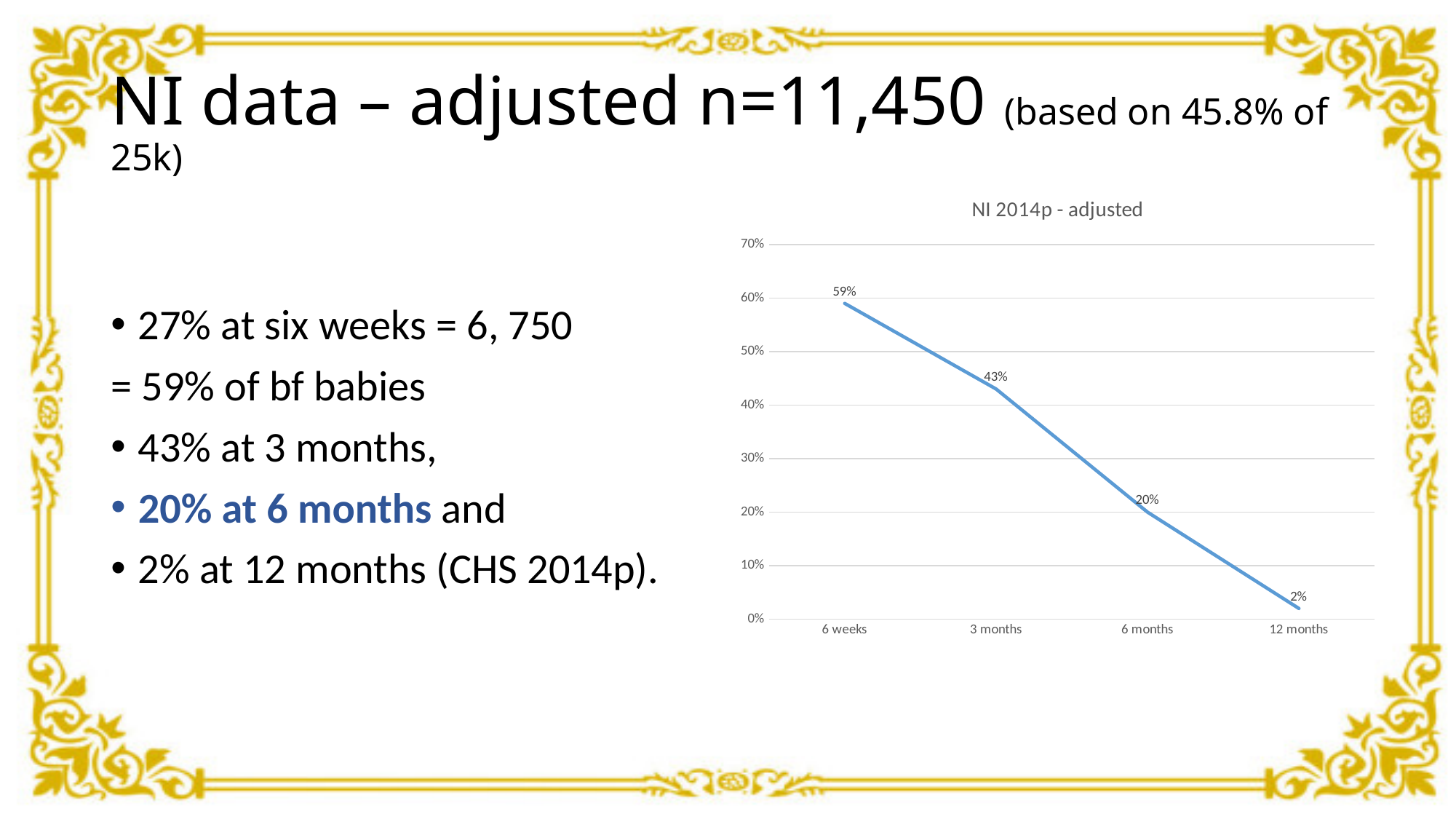
Which time point has the lowest value? 12 months How many time points are plotted on the chart? 4 Which time point has the highest value? 6 weeks What is the value at 6 months? 20% Do the values rise or fall from 6 weeks to 12 months? Fall What is the value at 3 months? 43% Which is larger, the value at 3 months or the value at 6 months? 3 months What is the difference between the values at 6 months and 12 months? 18% What is the difference between the values at 6 weeks and 3 months? 16% What is the value at 6 weeks? 59% What is the value at 12 months? 2% What kind of chart is shown? Line chart